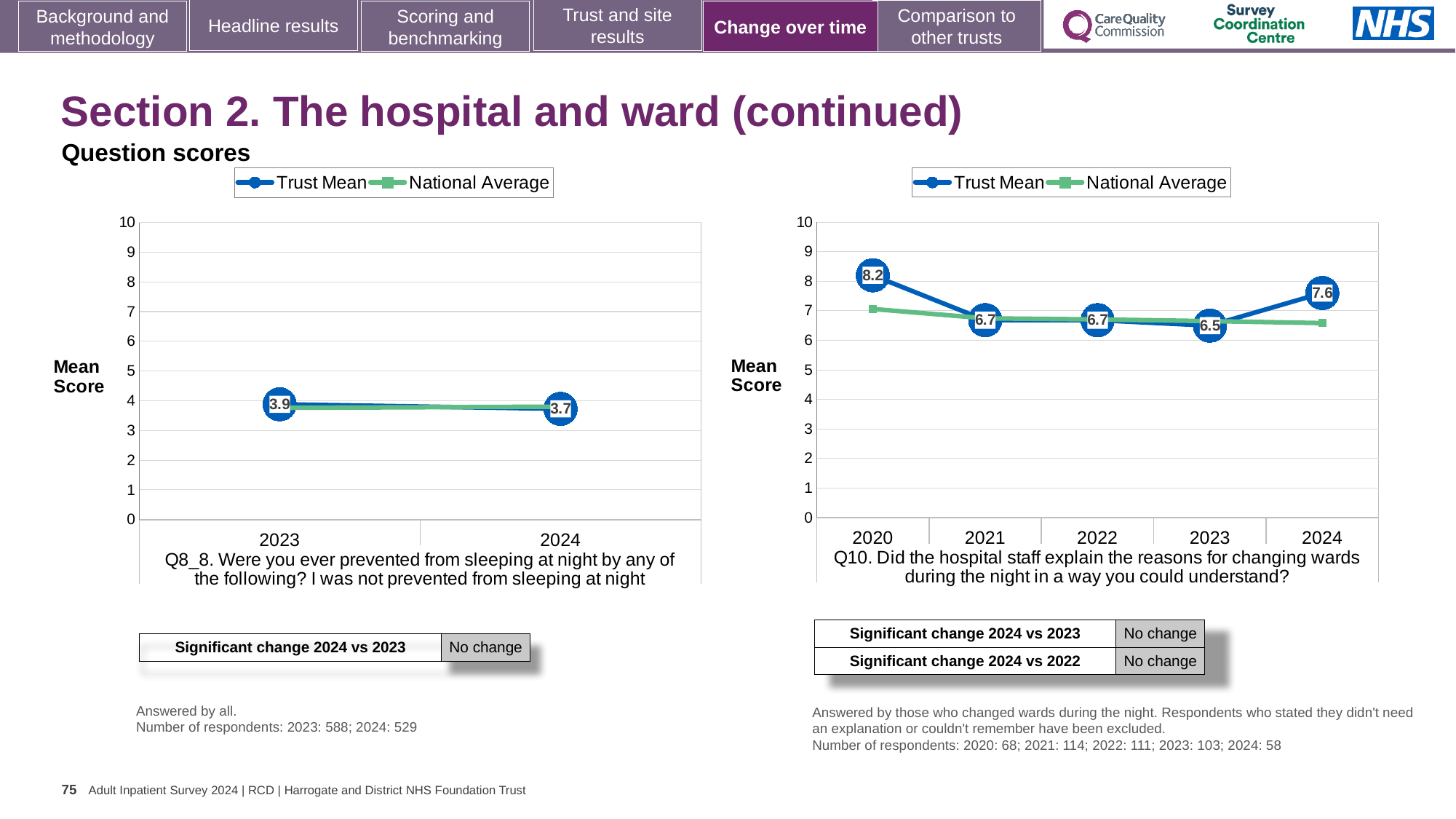
In the right chart (Q10), what is the Trust Mean score for 2020? 8.2 In the left chart (Q8_8), by how much did the Trust Mean change from 2023 to 2024? 0.2 In the right chart (Q10), what is the Trust Mean score for 2024? 7.6 In the left chart (Q8_8), what is the Trust Mean score for 2023? 3.9 In the left chart (Q8_8), does the Trust Mean rise or fall from 2023 to 2024? fall In the right chart (Q10), is the Trust Mean for 2024 higher or lower than the Trust Mean for 2023? higher In the right chart (Q10), which year has the lowest Trust Mean score? 2023 In the right chart (Q10), which year has the highest Trust Mean score? 2020 How many years are plotted on the x axis of the right chart (Q10)? 5 In the right chart (Q10), what is the difference between the Trust Mean in 2020 and in 2023? 1.7 In the right chart (Q10), is the National Average for 2020 greater or less than 8? less In the left chart (Q8_8), what is the Trust Mean score for 2024? 3.7